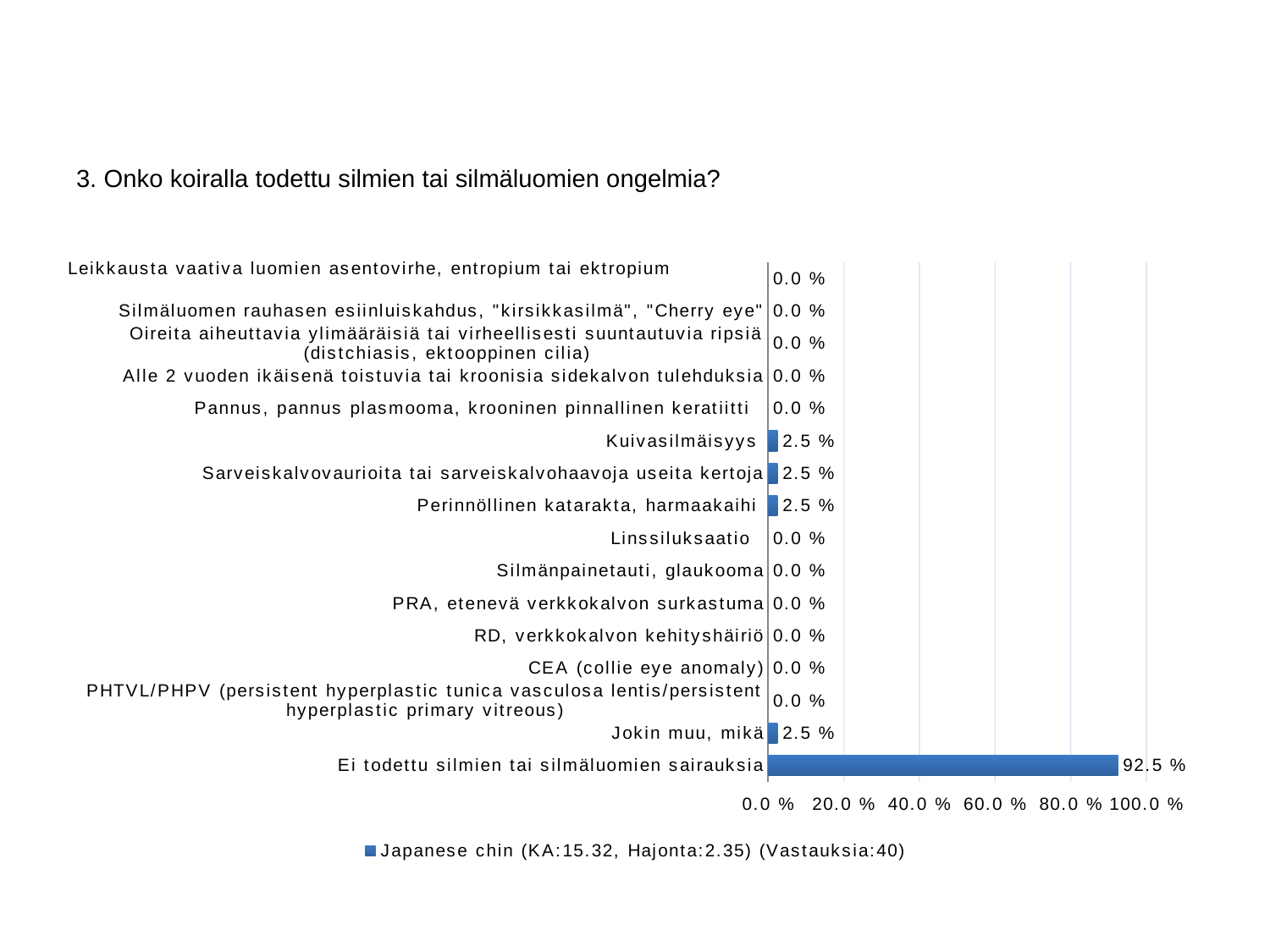
What is the value for "Ei todettu silmien tai silmäluomien sairauksia"? 92.5 % What kind of chart is shown on the slide? bar chart Which category has the highest value? Ei todettu silmien tai silmäluomien sairauksia What is the value for "Kuivasilmäisyys"? 2.5 % How many categories are shown in the chart? 16 What is the value for "Jokin muu, mikä"? 2.5 % Which is larger, the value for "Kuivasilmäisyys" or the value for "Silmänpainetauti, glaukooma"? Kuivasilmäisyys Is the value for "Ei todettu silmien tai silmäluomien sairauksia" greater or less than 80.0 %? greater How many series does the legend list? 1 What is the value for "Perinnöllinen katarakta, harmaakaihi"? 2.5 % What is the value for "Linssiluksaatio"? 0.0 % What is the difference between the values for "Ei todettu silmien tai silmäluomien sairauksia" and "Jokin muu, mikä"? 90.0 %